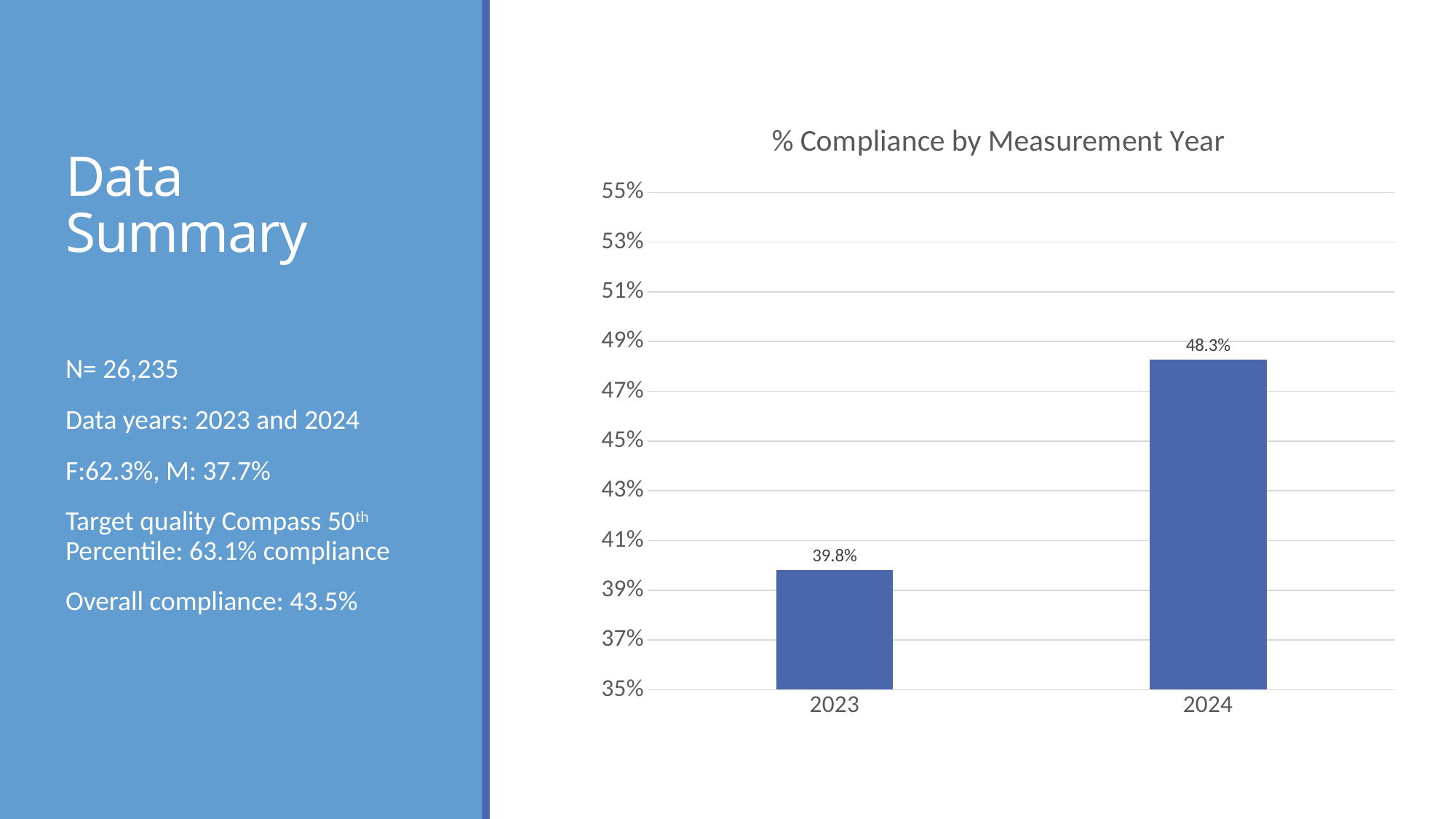
How many measurement years are shown in the chart? 2 Is the value for 2023 greater or less than 41%? less What is the % compliance value for 2023? 39.8% What is the difference in % compliance between 2024 and 2023? 8.5% Which measurement year has the highest % compliance? 2024 Which measurement year has the lowest % compliance? 2023 What is the title of the chart? % Compliance by Measurement Year What is the % compliance value for 2024? 48.3% Which is larger, the % compliance for 2023 or for 2024? 2024 Does % compliance rise or fall from 2023 to 2024? rise What kind of chart is shown on the slide? bar chart Is the value for 2024 greater or less than 45%? greater